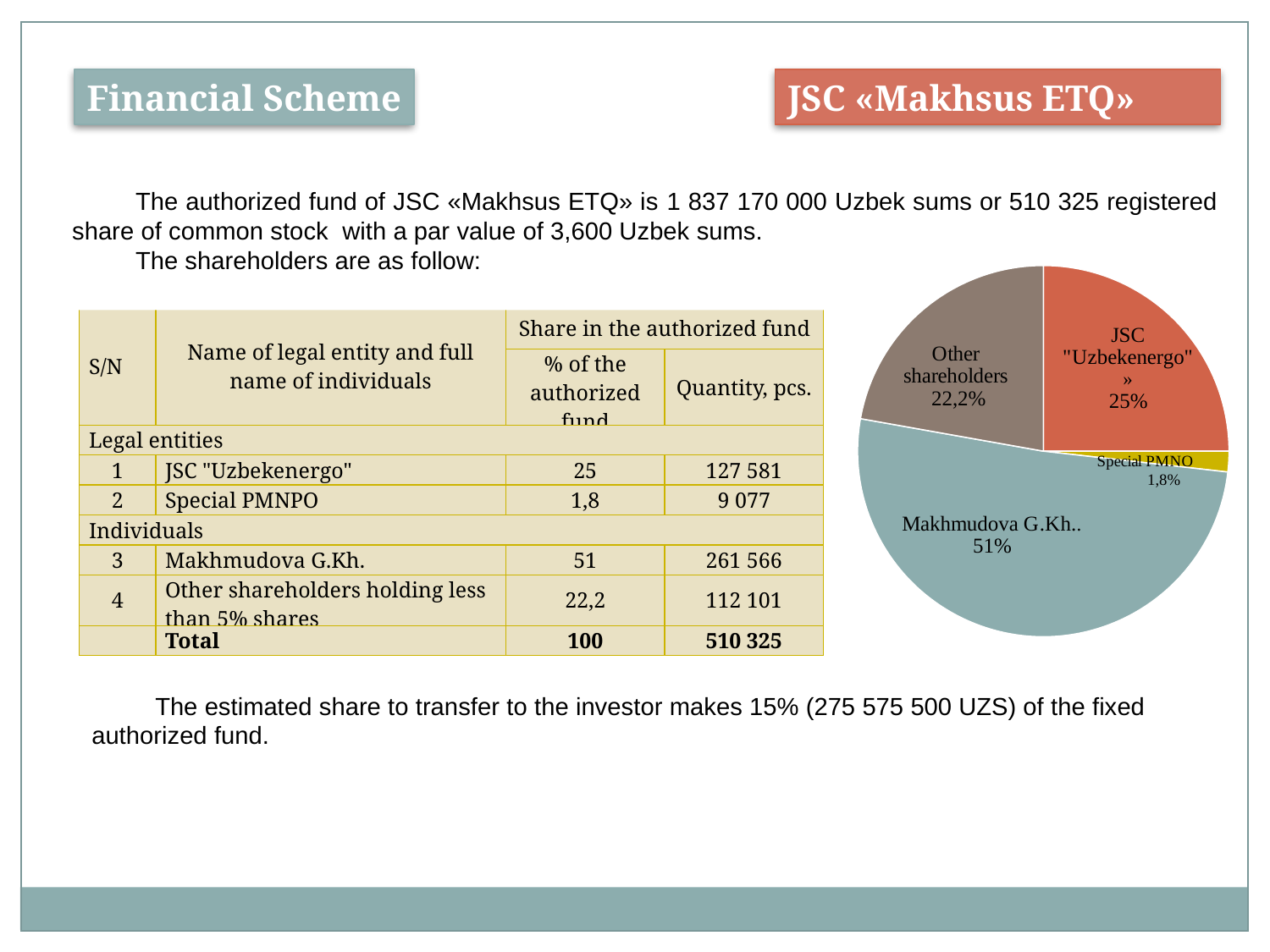
What share of the pie does Makhmudova G.Kh. hold? 51% What share of the pie do Other shareholders hold? 22,2% Which is larger in the pie chart: JSC "Uzbekenergo" or Other shareholders? JSC "Uzbekenergo" What share of the pie does Special PMNO hold? 1,8% What colour is the Makhmudova G.Kh. slice in the pie chart? teal (blue-green) Which slice of the pie chart is the smallest? Special PMNO How many slices does the pie chart have? 4 What is the difference in percentage points between the Makhmudova G.Kh. slice and the JSC "Uzbekenergo" slice? 26 What kind of chart is shown on the slide? pie chart Which slice of the pie chart is the largest? Makhmudova G.Kh.. What is the difference in percentage points between the Other shareholders slice and the Special PMNO slice? 20,4